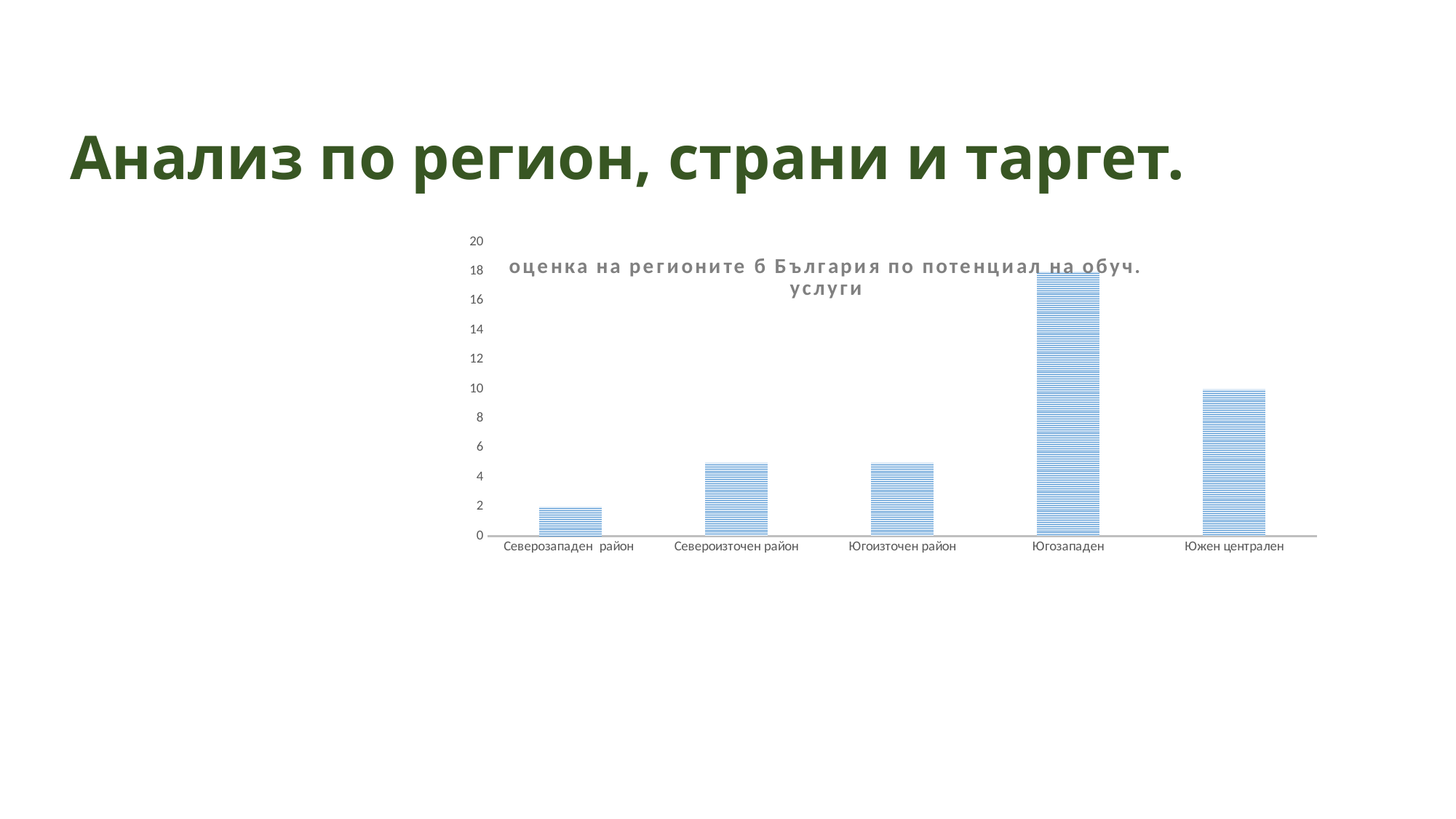
Which region has the lowest value in the chart? Северозападен район Is the value for Южен централен greater or less than 8? greater Is the value for Югозападен greater or less than 16? greater Is the value for Североизточен район greater or less than 6? less What kind of chart is shown on the slide? bar chart Which has a larger value, Югозападен or Южен централен? Югозападен Which has a larger value, Северозападен район or Североизточен район? Североизточен район What is the title of the chart? оценка на регионите б България по потенциал на обуч. услуги Which region has the highest value in the chart? Югозападен How many regions (categories) are plotted in the chart? 5